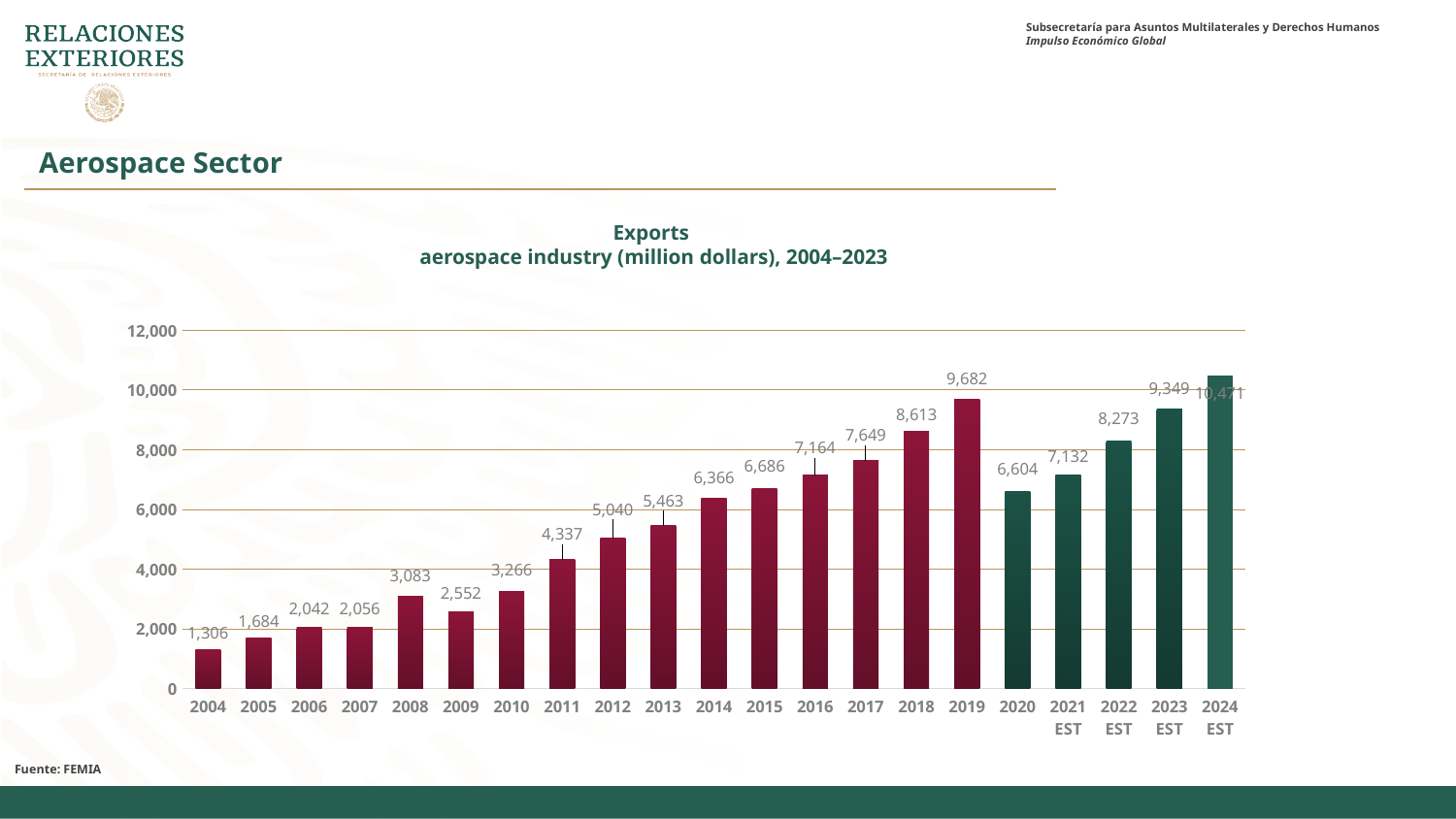
What is the value of aerospace exports for 2019? 9,682 Do aerospace exports generally rise or fall from 2004 to 2019? rise Which year has the larger export value, 2008 or 2009? 2008 What is the difference between the export values for 2019 and 2018? 1,069 What is the estimated value of aerospace exports for 2024 EST? 10,471 What is the value of aerospace exports for 2004? 1,306 How many years are shown on the x axis of the chart? 21 Is the export value for 2024 EST greater or less than 10,000? greater What kind of chart is used to show aerospace exports? bar chart Which year has the highest aerospace export value? 2024 EST Which year has the lowest aerospace export value? 2004 By how much did exports fall from 2019 to 2020? 3,078